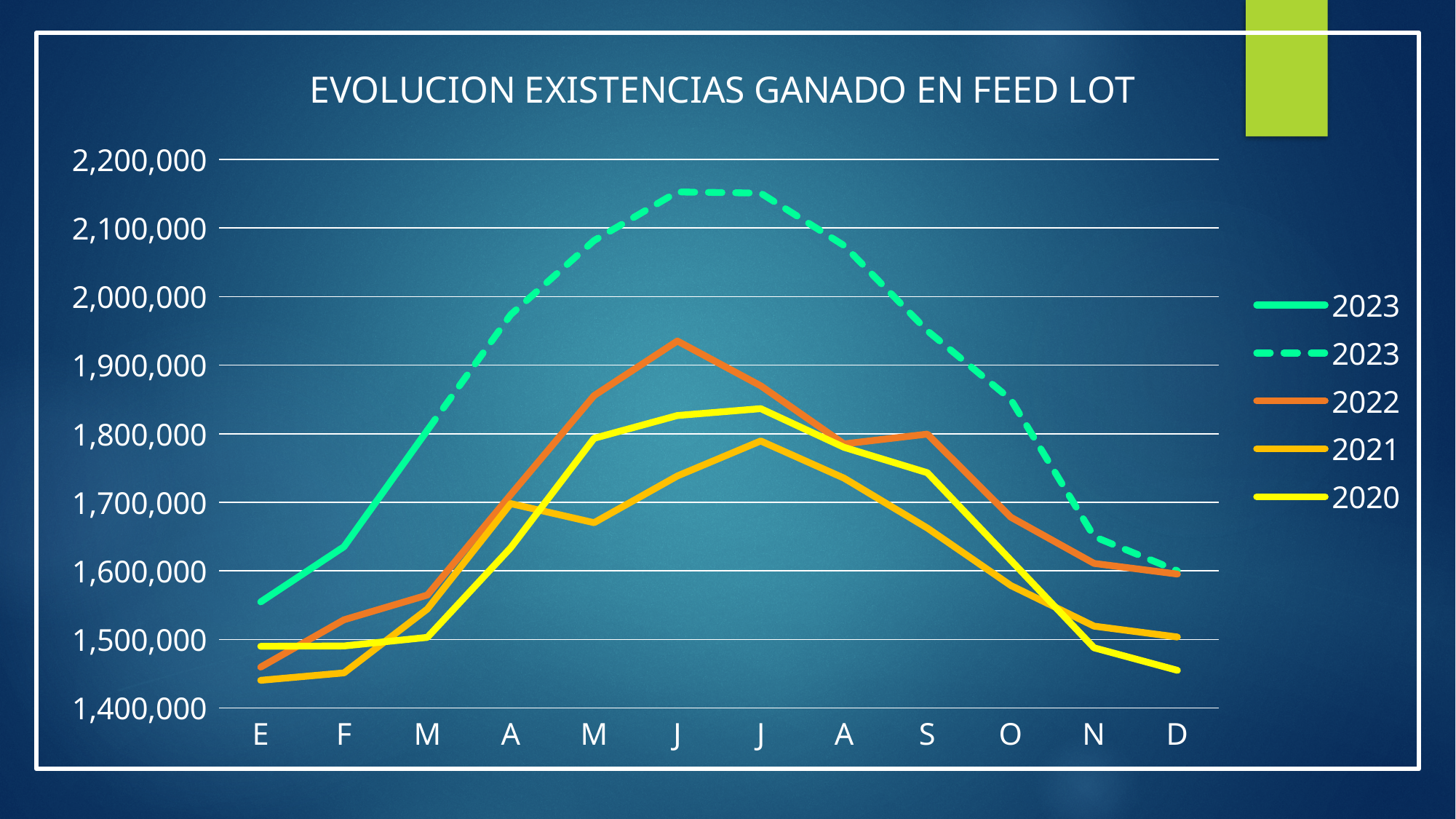
In which month does the 2021 series have its lowest value? E (January) Is the value for the 2022 series in May greater or less than 1,800,000? greater Is the value for the 2020 series in December (D) greater or less than 1,500,000? less Is the value for the dashed 2023 series in June (J) greater or less than 2,100,000? greater In June (J), which series is higher: 2022 or 2020? 2022 Does the solid 2023 line rise or fall from January (E) to March (M)? rise How many series does the legend list? 5 What kind of chart is shown on the slide? line chart In which month does the 2022 series reach its highest value? J (June) How many months are shown along the x axis? 12